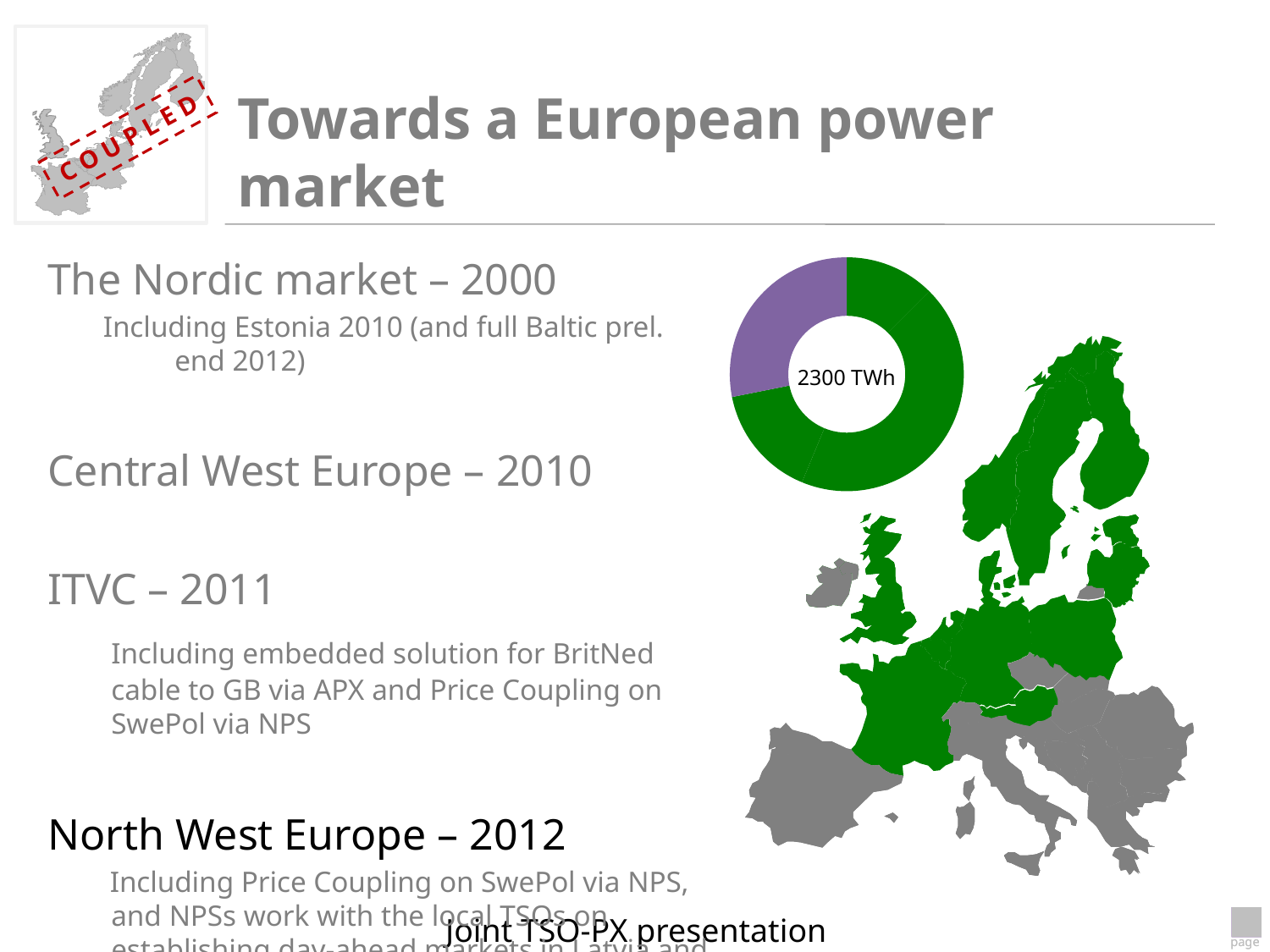
What kind of chart is shown on the right side of the slide? Doughnut chart Which two colours are used for the slices of the doughnut chart? Green and purple In the doughnut chart, which colour covers the larger share of the ring, green or purple? Green What value is printed in the centre of the doughnut chart? 2300 TWh